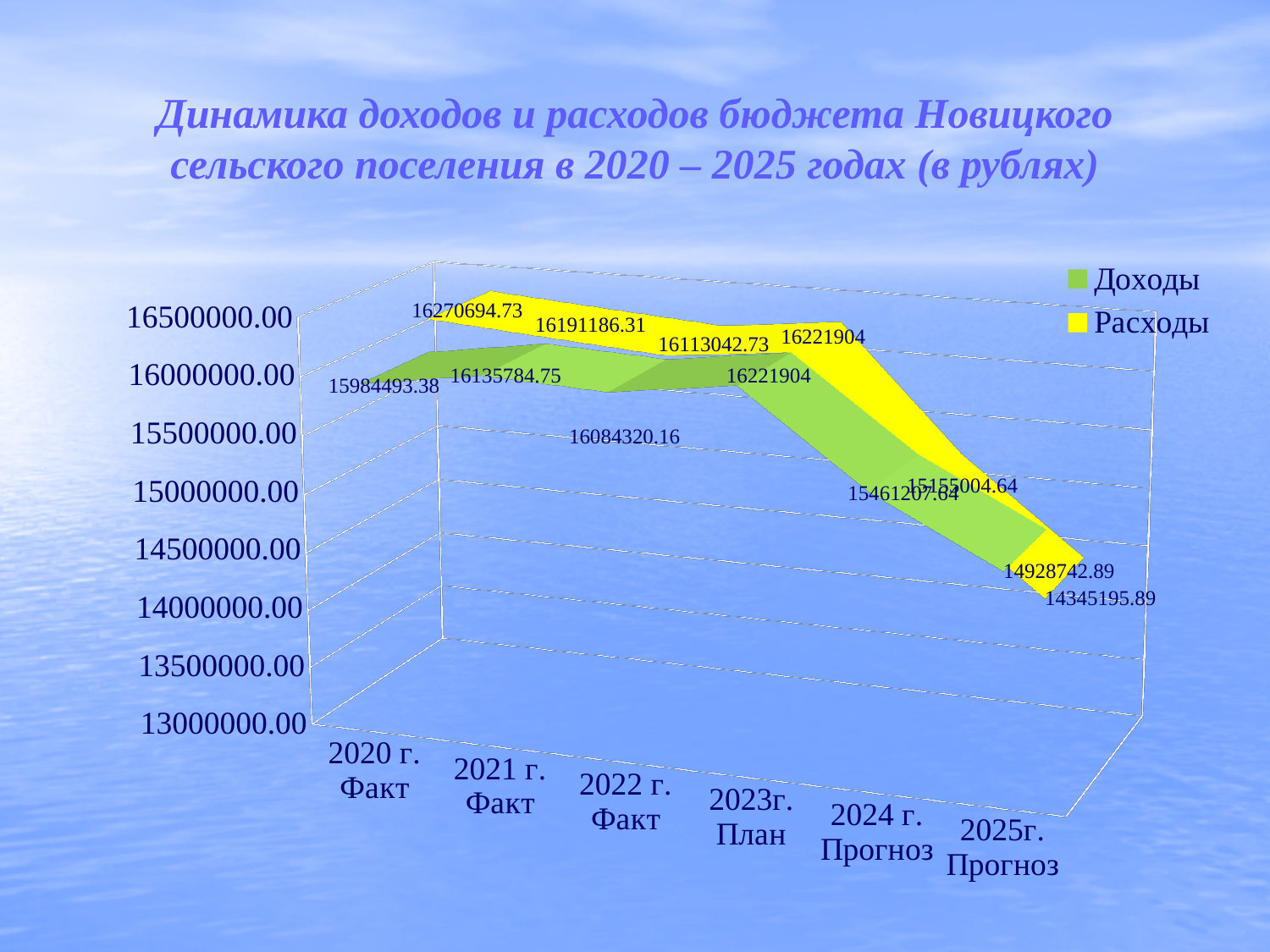
What is the value of Расходы for 2025г. Прогноз? 14345195.89 What is the value of Доходы for 2020 г. Факт? 15984493.38 What is the value of Расходы for 2020 г. Факт? 16270694.73 How many categories are shown on the x axis? 6 What is the value of Доходы for 2023г. План? 16221904 In which category is Доходы lowest? 2025г. Прогноз Do the Расходы values rise or fall from 2023г. План to 2025г. Прогноз? fall What is the value of Доходы for 2025г. Прогноз? 14928742.89 For 2020 г. Факт, which is larger: Доходы or Расходы? Расходы What is the difference between Доходы and Расходы for 2025г. Прогноз? 583547 In which category is Расходы highest? 2020 г. Факт How many series does the legend list? 2